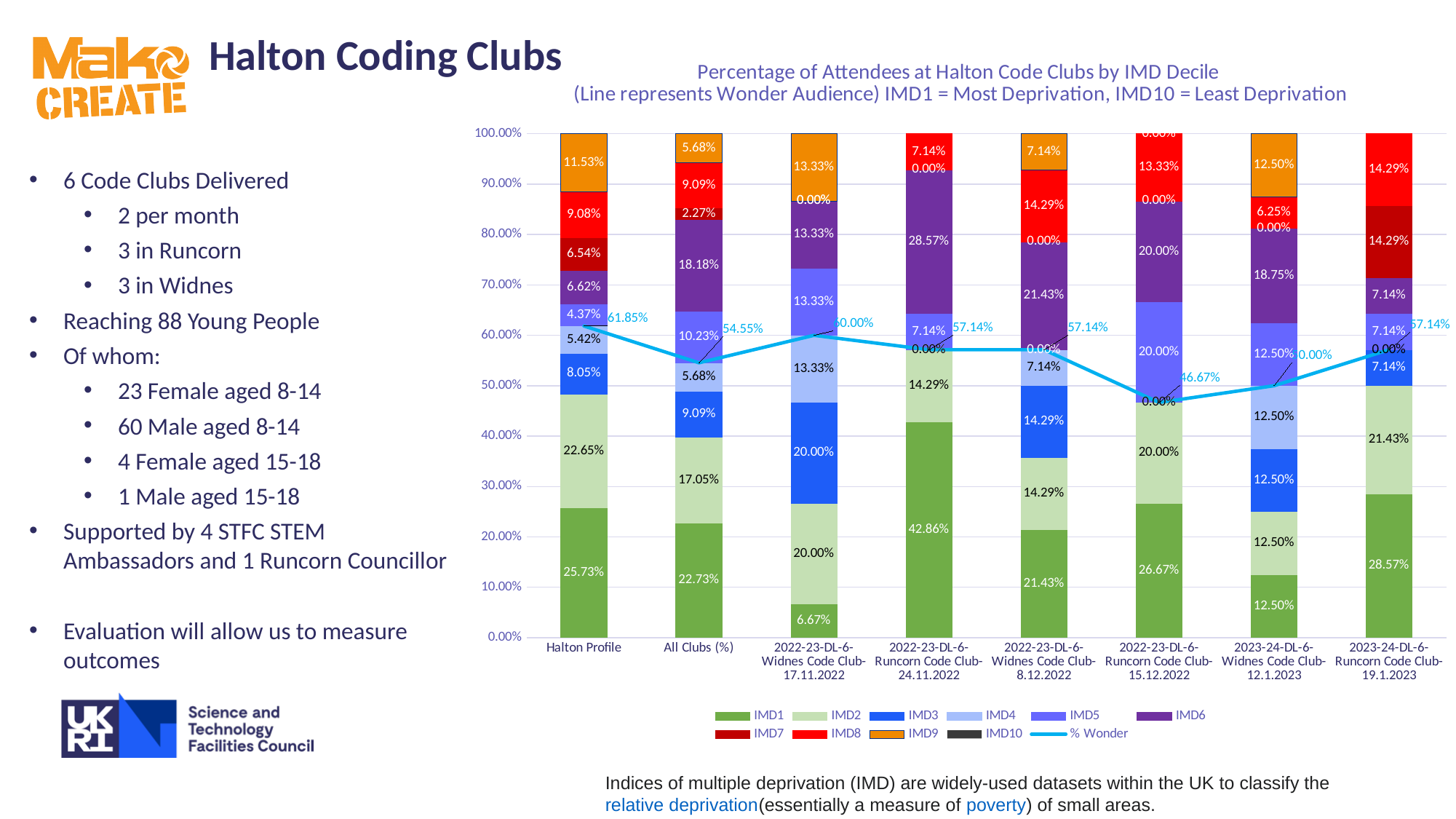
According to the chart title, what does the line represent? Wonder Audience How many categories are shown on the x axis? 8 Is the % Wonder value for Halton Profile greater or less than 60.00%? greater Which category has the highest IMD1 value? 2022-23-DL-6-Runcorn Code Club-24.11.2022 Which is larger: the IMD2 value for Halton Profile or the IMD2 value for All Clubs (%)? Halton Profile What is the difference between the IMD1 value for Halton Profile and the IMD1 value for All Clubs (%)? 3.00% What is the IMD1 value for Halton Profile? 25.73% What is the % Wonder value for 2022-23-DL-6-Runcorn Code Club-15.12.2022? 46.67% What kind of chart is this? Stacked bar chart with a line Which category has the lowest % Wonder value? 2022-23-DL-6-Runcorn Code Club-15.12.2022 How many series does the legend list? 11 What is the IMD6 value for 2022-23-DL-6-Runcorn Code Club-24.11.2022? 28.57%